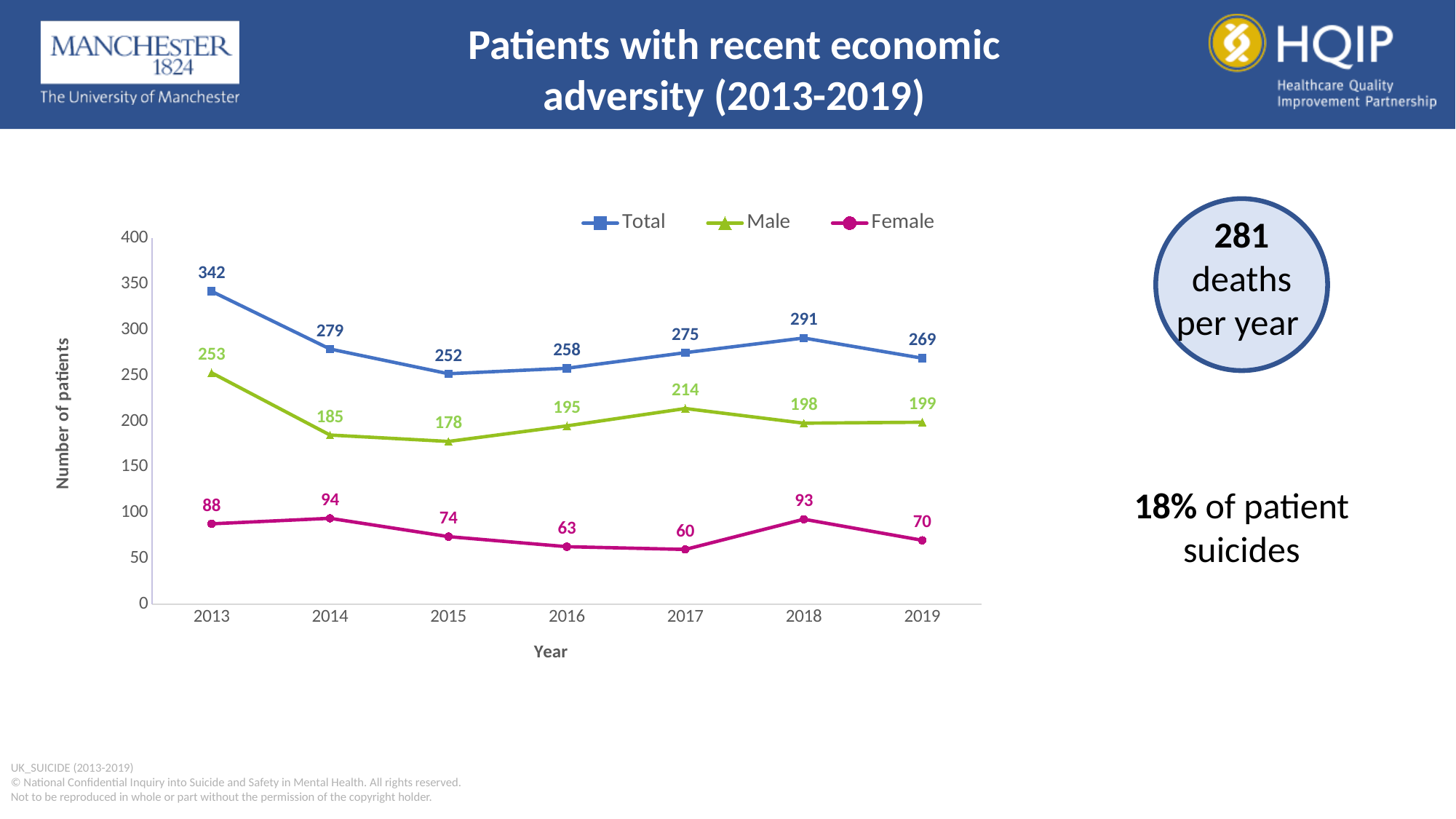
In which year is the Total series highest? 2013 Which is larger, the Male value for 2018 or the Male value for 2019? 2019 In which year is the Female series lowest? 2017 What is the Total value for 2013? 342 Does the Total series rise or fall from 2013 to 2015? fall How many series does the legend list? 3 How many years are shown on the x axis? 7 What is the Female value for 2016? 63 What is the Male value for 2017? 214 What is the difference between the Total values for 2013 and 2014? 63 What kind of chart is shown on the slide? line chart Is the Total value for 2015 greater or less than 300? less